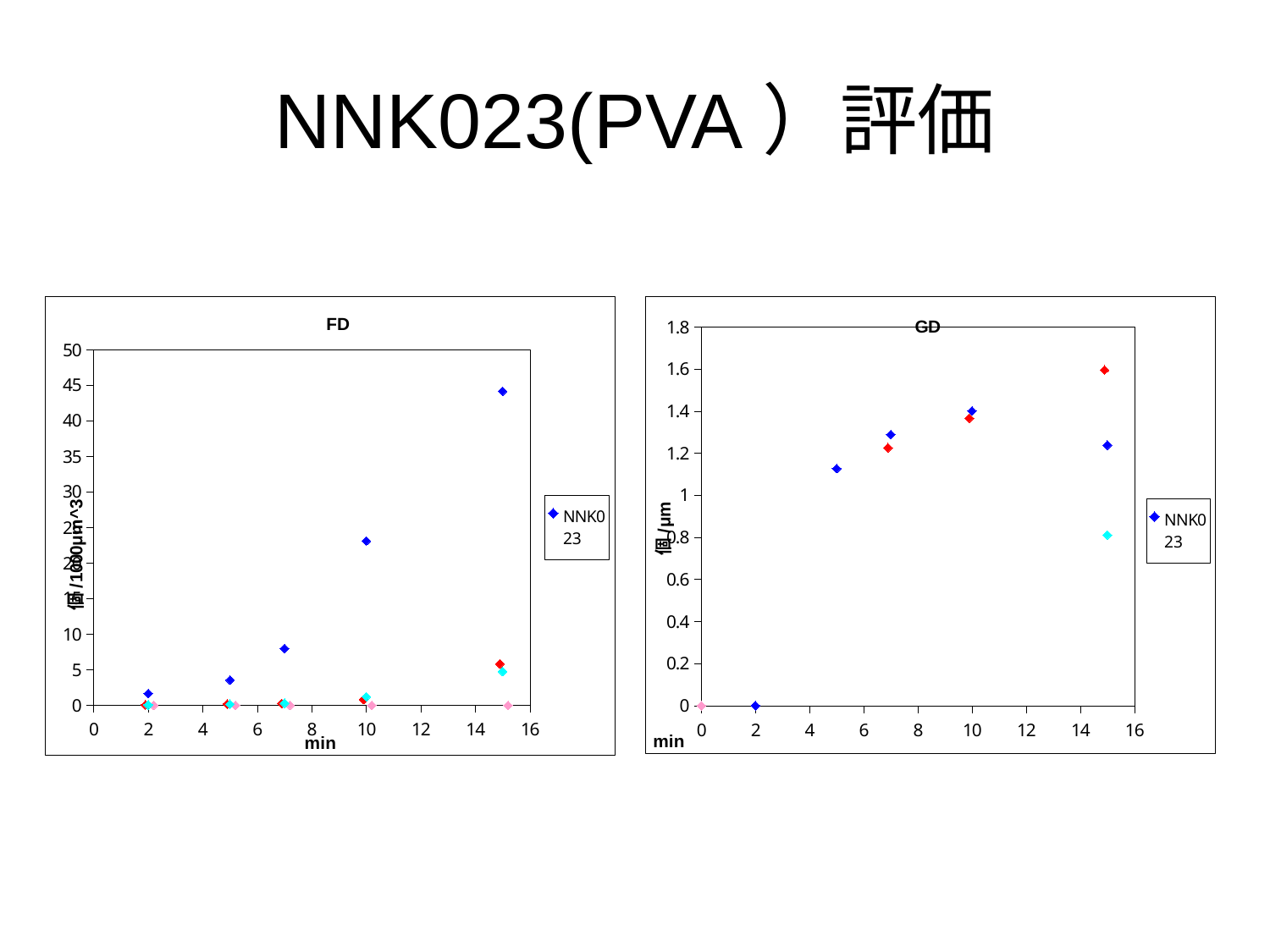
In the GD chart, is the cyan value at 15 min greater or less than 1? less What is the title of the chart on the right? GD What kind of chart is the FD chart on the left? scatter chart In the FD chart, is the blue value at 7 min greater or less than 10? less In the GD chart, which is larger at 15 min: the red value or the cyan value? red In the GD chart, do the blue values rise or fall as time increases from 2 to 10 min? rise In the FD chart, which is larger for the blue series: the value at 10 min or the value at 15 min? 15 min In the FD chart, is the blue value at 10 min greater or less than 20? greater In the FD chart, do the blue values rise or fall as time increases from 2 to 15 min? rise What is the x-axis label on the FD chart? min